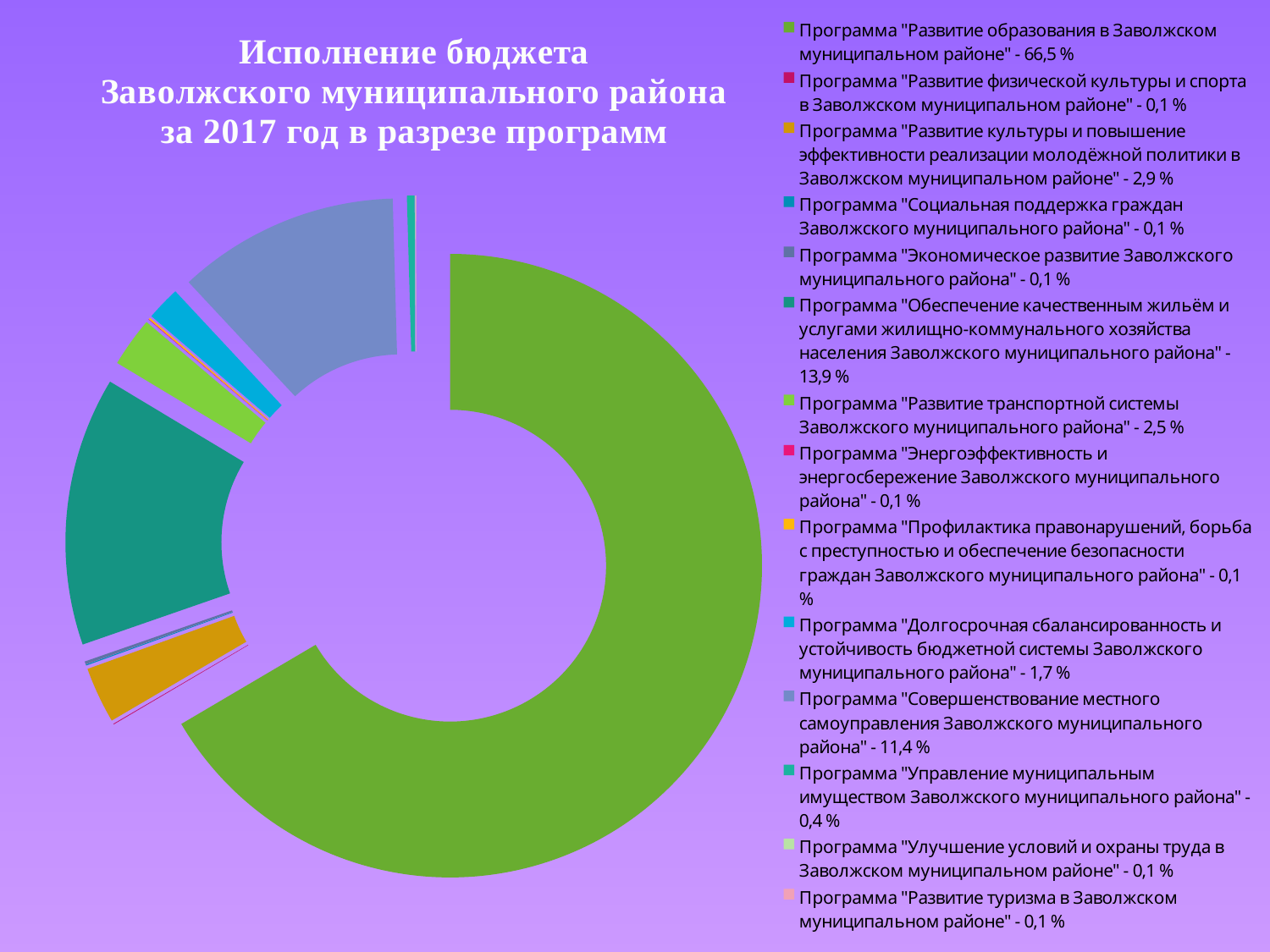
How many programmes are listed in the legend? 14 What share of the budget went to the programme "Управление муниципальным имуществом Заволжского муниципального района"? 0,4 % Which has the larger share: the programme "Развитие культуры и повышение эффективности реализации молодёжной политики" or the programme "Развитие транспортной системы"? Программа "Развитие культуры и повышение эффективности реализации молодёжной политики" (2,9 %) What share of the budget went to the programme "Развитие образования в Заволжском муниципальном районе"? 66,5 % What share of the budget went to the programme "Долгосрочная сбалансированность и устойчивость бюджетной системы Заволжского муниципального района"? 1,7 % What is the difference in share between the programme "Обеспечение качественным жильём и услугами ЖКХ" (13,9 %) and the programme "Совершенствование местного самоуправления" (11,4 %)? 2,5 % What type of chart is shown on the slide? Doughnut (pie) chart Which programme has the largest share of the budget? Программа "Развитие образования в Заволжском муниципальном районе" What share of the budget went to the programme "Совершенствование местного самоуправления Заволжского муниципального района"? 11,4 % What is the difference in share between the programme "Развитие образования" (66,5 %) and the programme "Обеспечение качественным жильём и услугами ЖКХ" (13,9 %)? 52,6 % For which year does the chart show the budget execution of the Заволжский municipal district? 2017 What share of the budget went to the programme "Обеспечение качественным жильём и услугами жилищно-коммунального хозяйства населения Заволжского муниципального района"? 13,9 %